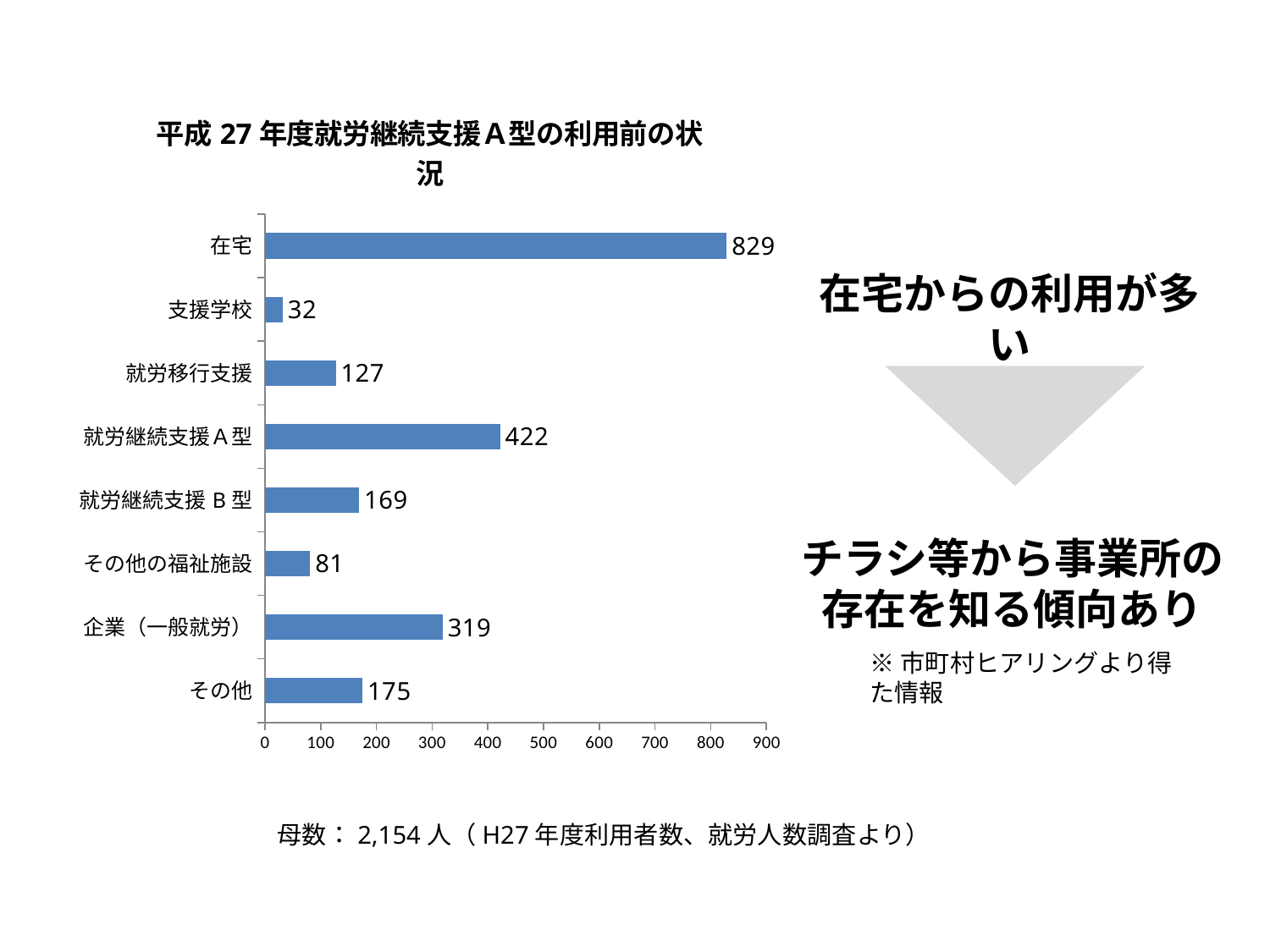
Which category has the highest value? 在宅 What kind of chart is shown on the slide? bar chart Which is larger, the value for 企業（一般就労） or the value for その他? 企業（一般就労） What is the difference between the values for 就労継続支援Ｂ型 and 就労移行支援? 42 Which category has the lowest value? 支援学校 What is the value for 在宅? 829 What is the value for 支援学校? 32 What is the value for 企業（一般就労）? 319 What is the difference between the values for 在宅 and 就労継続支援Ａ型? 407 How many categories are shown in the chart? 8 Is the value for その他の福祉施設 greater or less than 100? less What is the value for 就労継続支援Ａ型? 422